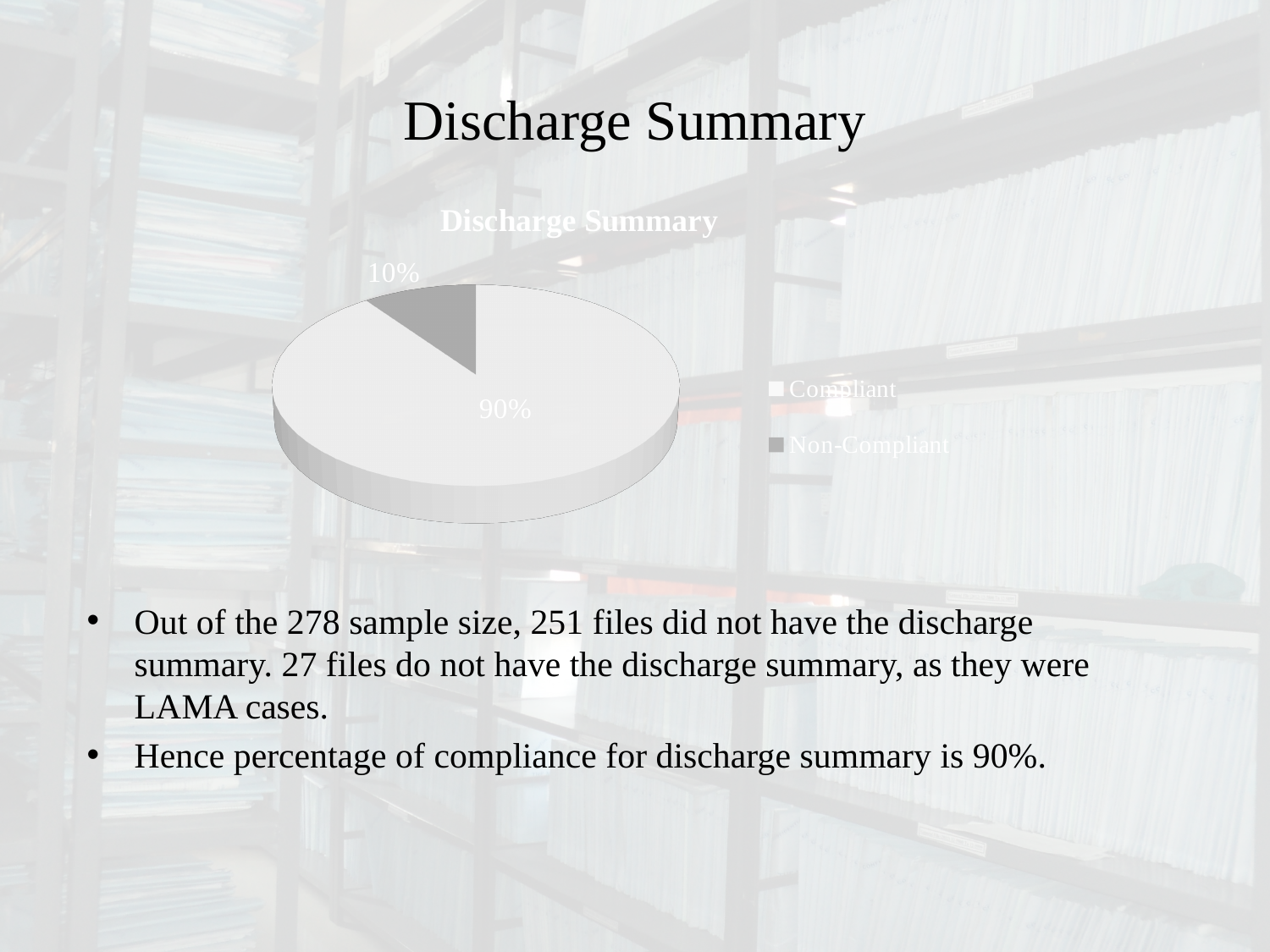
What is the title of the chart? Discharge Summary Which category has the smallest share of the pie? Non-Compliant What kind of chart is shown on the slide? Pie chart What is the difference in percentage points between the Compliant and Non-Compliant slices? 80 How many slices does the pie chart have? 2 What percentage of the pie is labelled Non-Compliant? 10% Which category has the largest share of the pie? Compliant Which is larger, the Compliant slice or the Non-Compliant slice? Compliant How many entries does the legend list? 2 Which legend entry is shown in the darker grey colour? Non-Compliant What percentage of the pie is labelled Compliant? 90% What share of the pie does the Compliant slice take? 90%